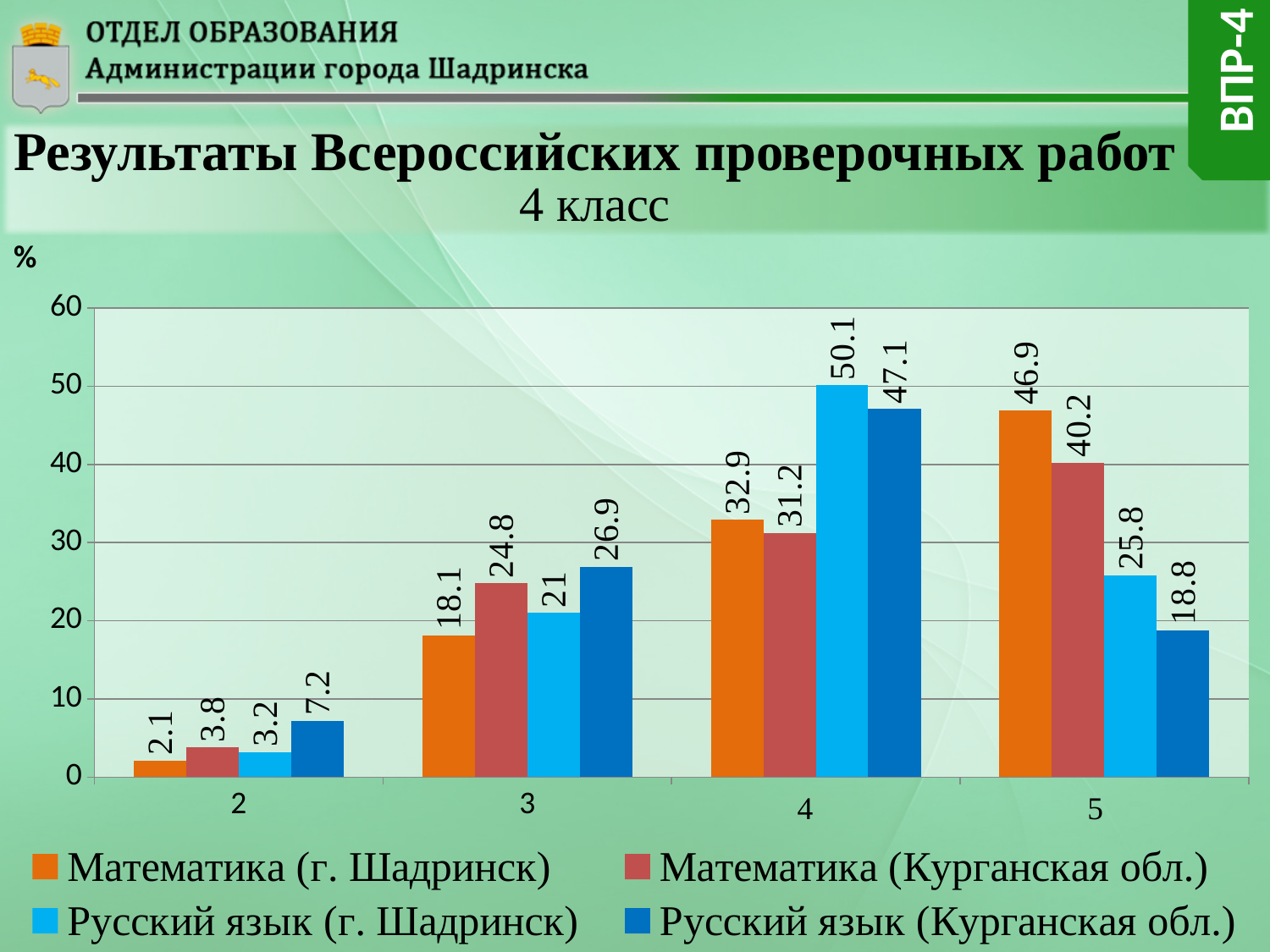
What is the value for Русский язык (г. Шадринск) in category 4? 50.1 In category 3, which is larger: Математика (г. Шадринск) or Математика (Курганская обл.)? Математика (Курганская обл.) What is the value for Математика (г. Шадринск) in category 5? 46.9 What is the difference between Математика (г. Шадринск) and Математика (Курганская обл.) in category 5? 6.7 How many series does the legend list? 4 Do the values for Математика (г. Шадринск) rise or fall from category 2 to category 5? rise What kind of chart is shown on the slide? bar chart In which category is the value for Русский язык (г. Шадринск) lowest? 2 What is the value for Русский язык (Курганская обл.) in category 3? 26.9 Is the value for Русский язык (Курганская обл.) in category 4 greater or less than 40? greater In which category is the value for Математика (Курганская обл.) highest? 5 How many categories are shown on the x axis? 4